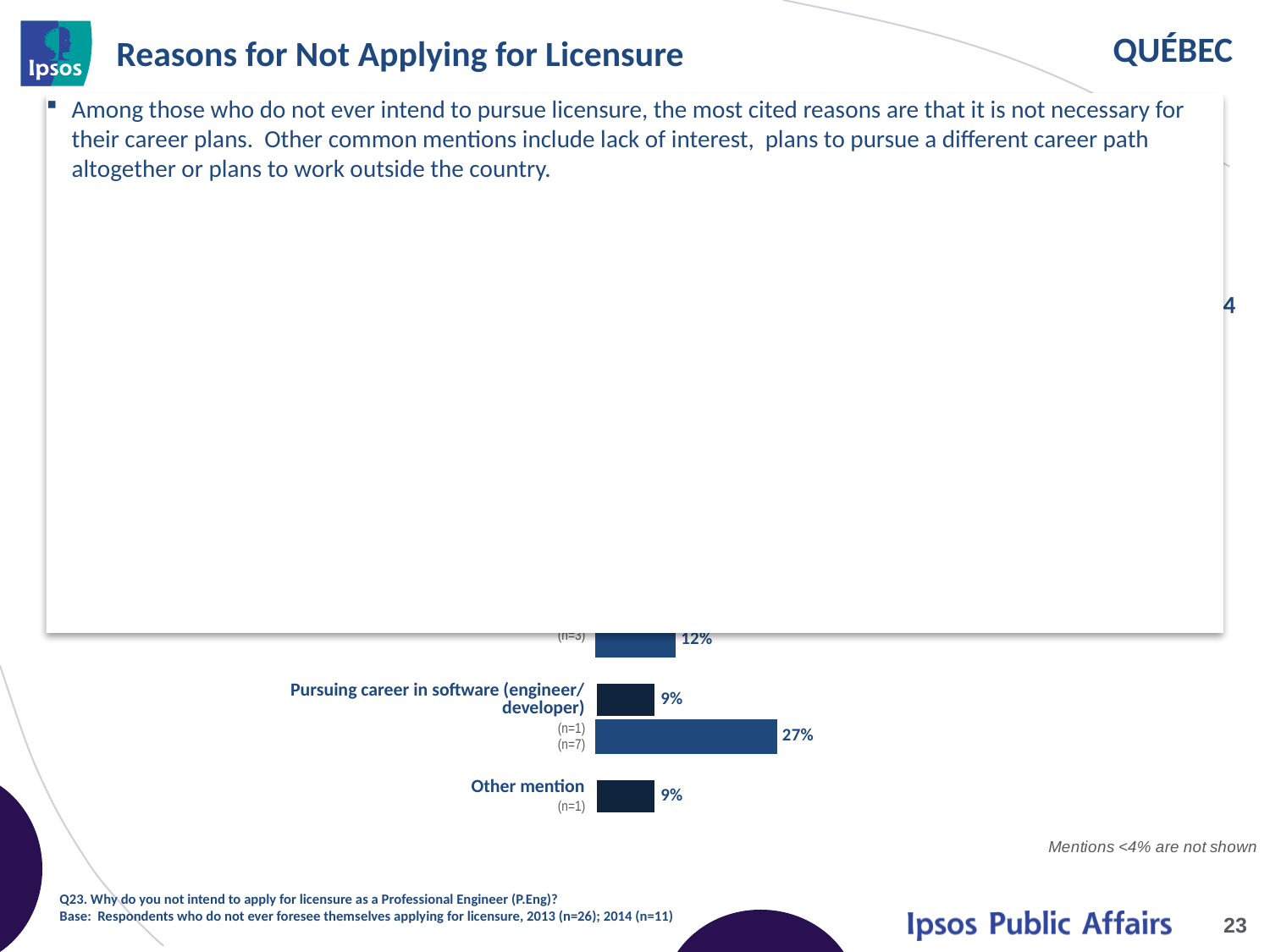
What value is shown for the dark navy bar for "Pursuing career in software (engineer/developer)"? 9% What is the 2014 base size given in the footnote of the chart? n=11 For "Pursuing career in software (engineer/developer)", which bar is larger, the dark navy bar or the lighter blue bar? The lighter blue bar (27%) Which is larger: the 27% bar for "Pursuing career in software (engineer/developer)" or the bar for "Other mention"? Pursuing career in software (engineer/developer) What sample size (n) is shown next to the 27% bar? n=7 What is the difference between the two bars shown for "Pursuing career in software (engineer/developer)" (27% and 9%)? 18 percentage points What sample size (n) is shown for the "Other mention" bar? n=1 According to the note under the chart, which mentions are not shown? Mentions <4% are not shown What value is shown for the "Other mention" bar? 9% What kind of chart is shown on the slide? Bar chart (horizontal) What value is shown for the lighter blue bar for "Pursuing career in software (engineer/developer)"? 27%